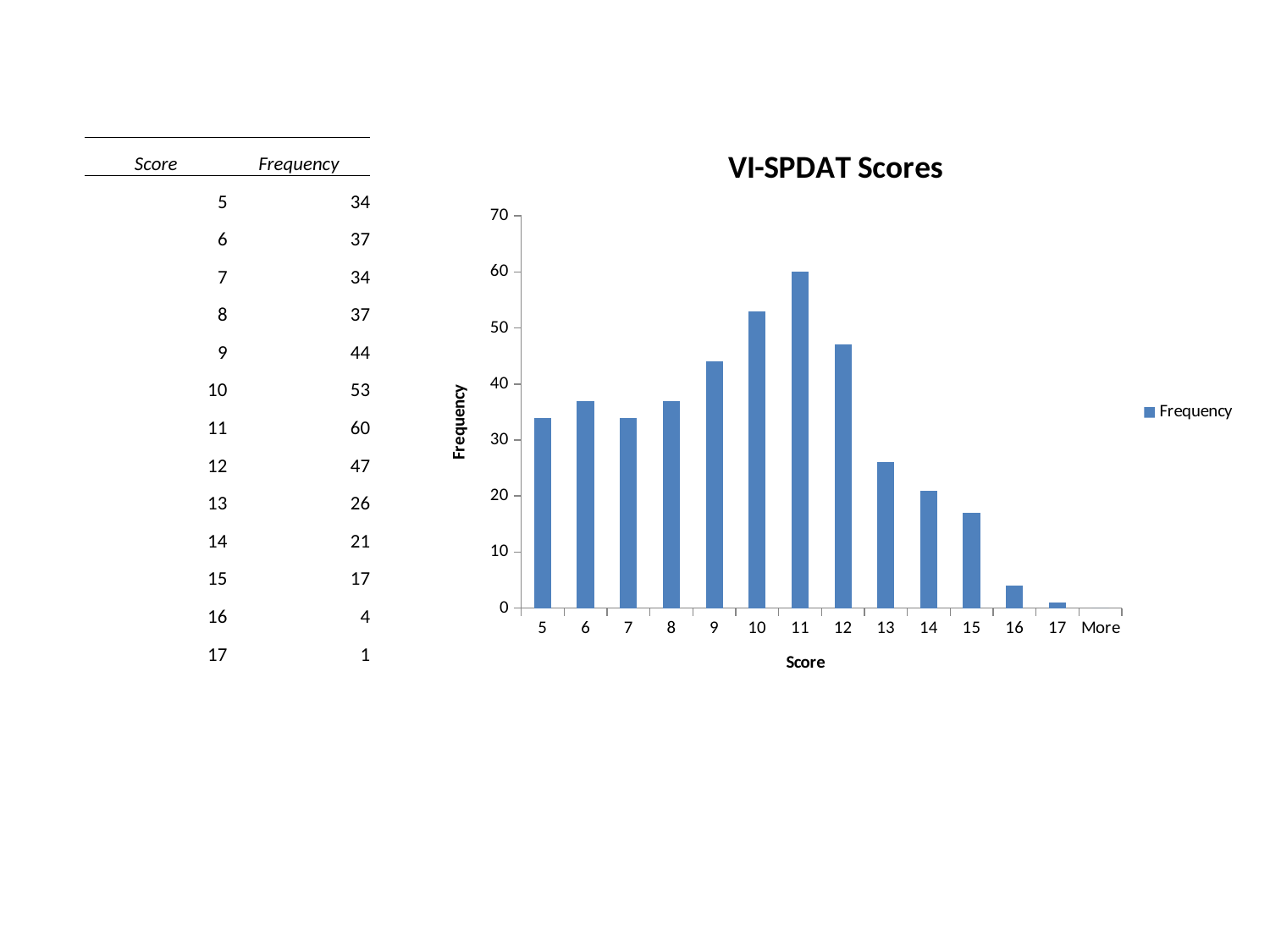
What is the frequency for score 10? 53 What type of chart is shown on the slide? bar chart Do the frequencies rise or fall from score 12 to score 17? fall How many series does the chart legend list? 1 How many categories are shown on the x axis of the chart? 14 What is the frequency for score 11? 60 Is the frequency for score 14 greater or less than 30? less What is the difference between the frequency for score 11 and the frequency for score 12? 13 What is the title of the chart? VI-SPDAT Scores Which has a higher frequency, score 9 or score 13? score 9 What is the frequency for score 17? 1 Which score has the highest frequency? 11